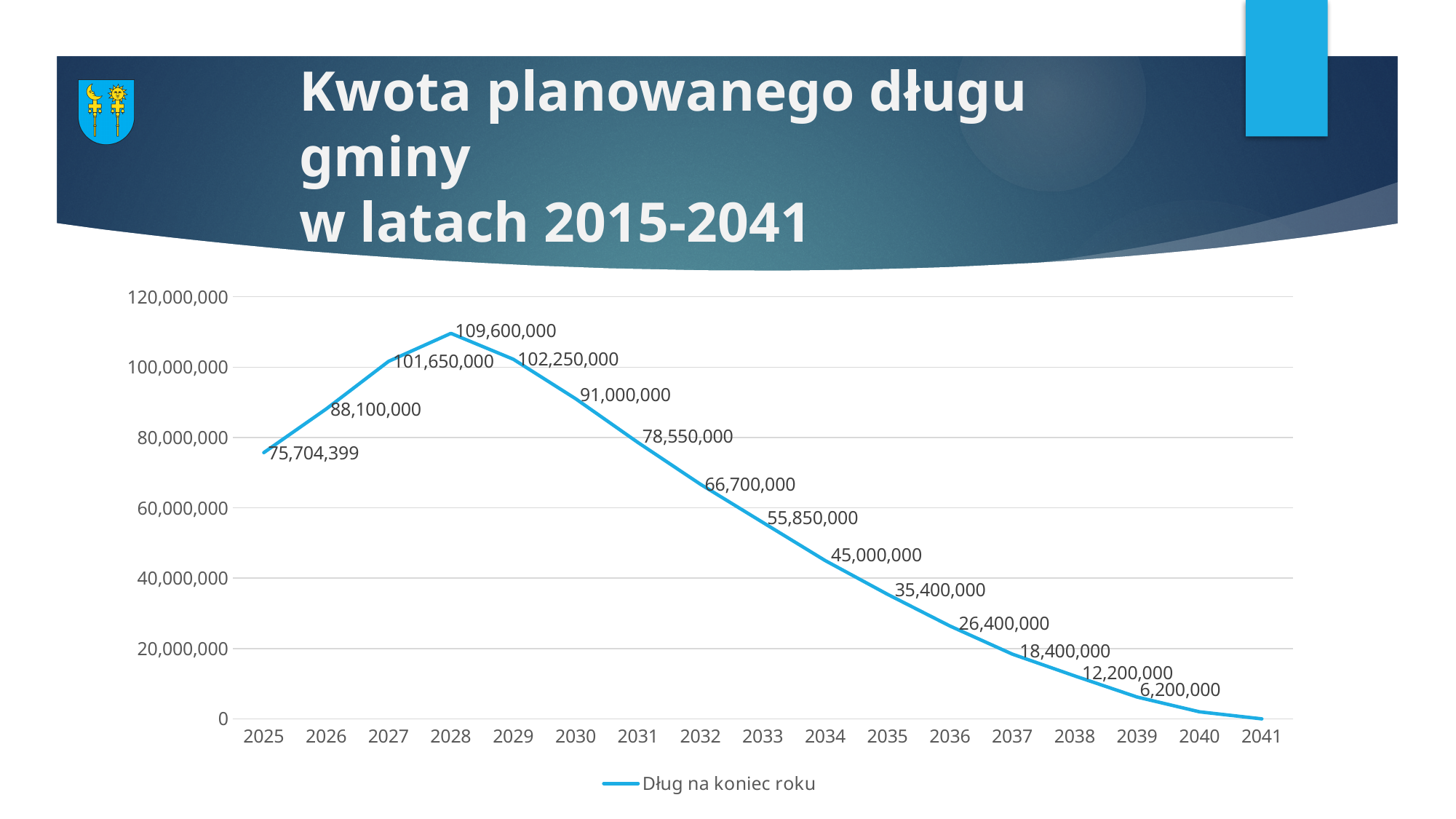
How many series does the legend list? 1 Do the values rise or fall from 2028 to 2041? fall Is the value for 2040 greater or less than 20,000,000? less What is the value for 2028? 109,600,000 Which year has the highest value? 2028 What is the difference between the values for 2030 and 2031? 12,450,000 What kind of chart is shown? line chart Which is larger, the value for 2029 or the value for 2027? 2029 What is the value for 2025? 75,704,399 What is the value for 2034? 45,000,000 How many years are shown on the x axis? 17 What is the difference between the values for 2028 and 2027? 7,950,000